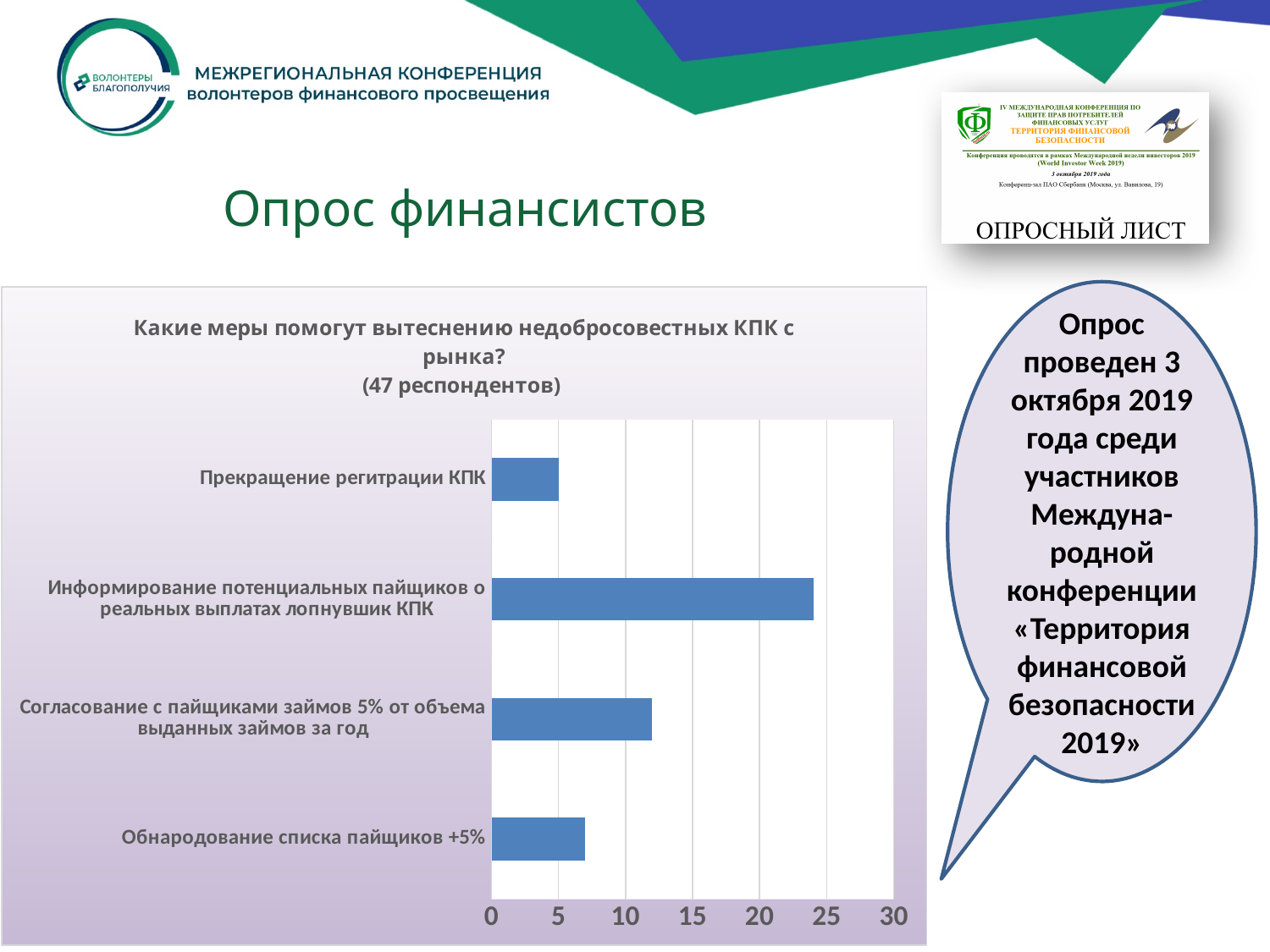
Is the value for 'Информирование потенциальных пайщиков о реальных выплатах лопнувшик КПК' greater or less than 20? greater What kind of chart is shown on the slide? Bar chart How many categories (measures) are plotted in the chart? 4 Is the value for 'Согласование с пайщиками займов 5% от объема выданных займов за год' greater or less than 10? greater Which measure received the lowest value in the chart? Прекращение регитрации КПК Is the value for 'Прекращение регитрации КПК' greater or less than 10? less Which measure received the highest value in the chart? Информирование потенциальных пайщиков о реальных выплатах лопнувшик КПК How many respondents does the chart title say took part in the survey? 47 Which has a larger value: 'Прекращение регитрации КПК' or 'Информирование потенциальных пайщиков о реальных выплатах лопнувшик КПК'? Информирование потенциальных пайщиков о реальных выплатах лопнувшик КПК Which has a larger value: 'Согласование с пайщиками займов 5% от объема выданных займов за год' or 'Обнародование списка пайщиков +5%'? Согласование с пайщиками займов 5% от объема выданных займов за год What is the maximum value shown on the chart's horizontal axis? 30